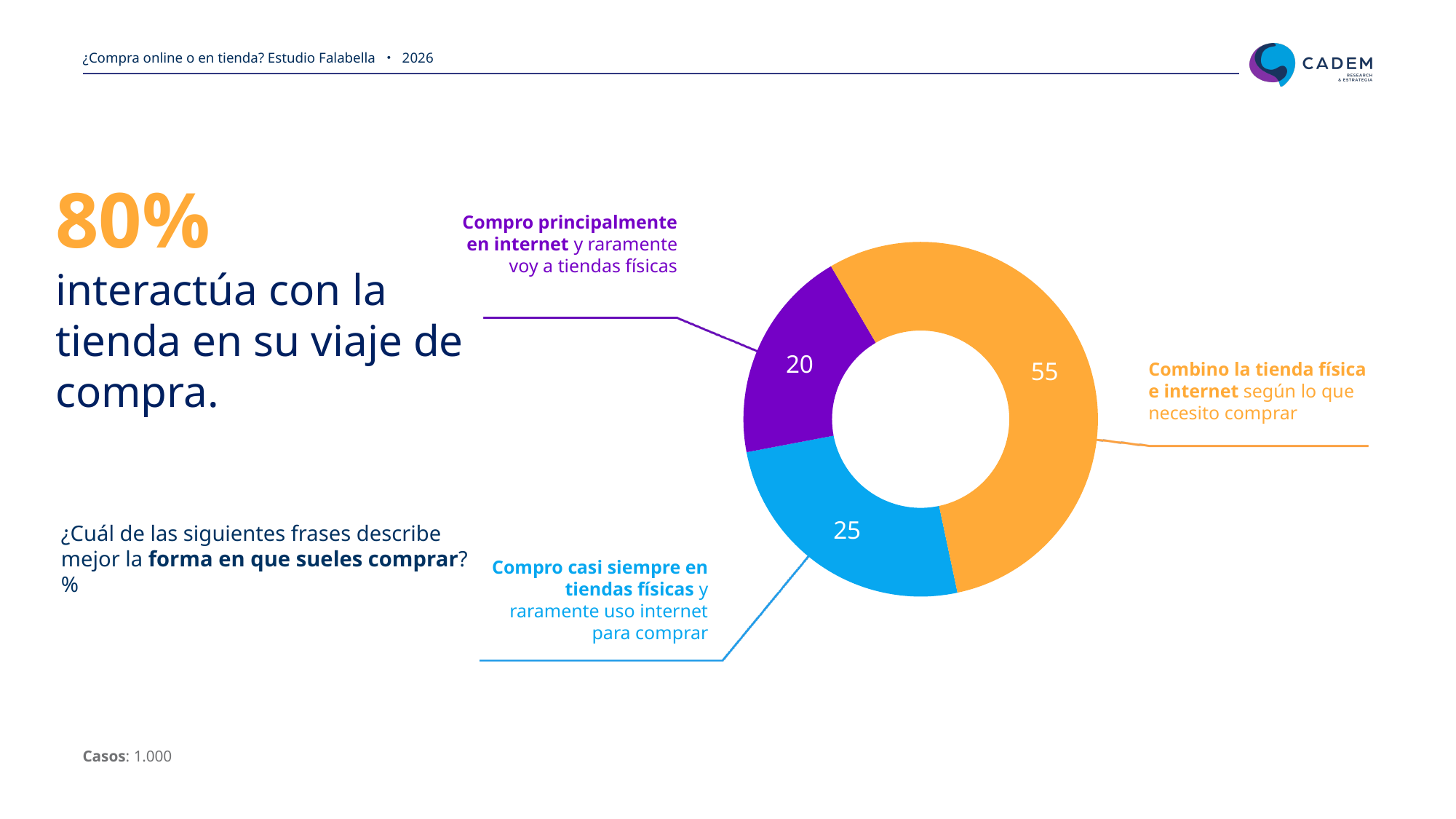
What value is shown for the slice 'Compro casi siempre en tiendas físicas y raramente uso internet para comprar'? 25 What is the number of cases ('Casos') stated on the slide? 1.000 Which category has the smallest slice in the chart? Compro principalmente en internet y raramente voy a tiendas físicas Which is larger: the value for 'Compro casi siempre en tiendas físicas' or the value for 'Compro principalmente en internet'? Compro casi siempre en tiendas físicas What value is shown for the slice 'Combino la tienda física e internet según lo que necesito comprar'? 55 Which category has the largest slice in the chart? Combino la tienda física e internet según lo que necesito comprar How many categories are shown in the chart? 3 What kind of chart is shown on the slide? Doughnut (pie) chart What is the difference between the value for 'Combino la tienda física e internet' and the value for 'Compro casi siempre en tiendas físicas'? 30 What colour is the slice for 'Compro principalmente en internet y raramente voy a tiendas físicas'? Purple What share of the chart does the 'Compro casi siempre en tiendas físicas' slice represent? 25% What value is shown for the slice 'Compro principalmente en internet y raramente voy a tiendas físicas'? 20